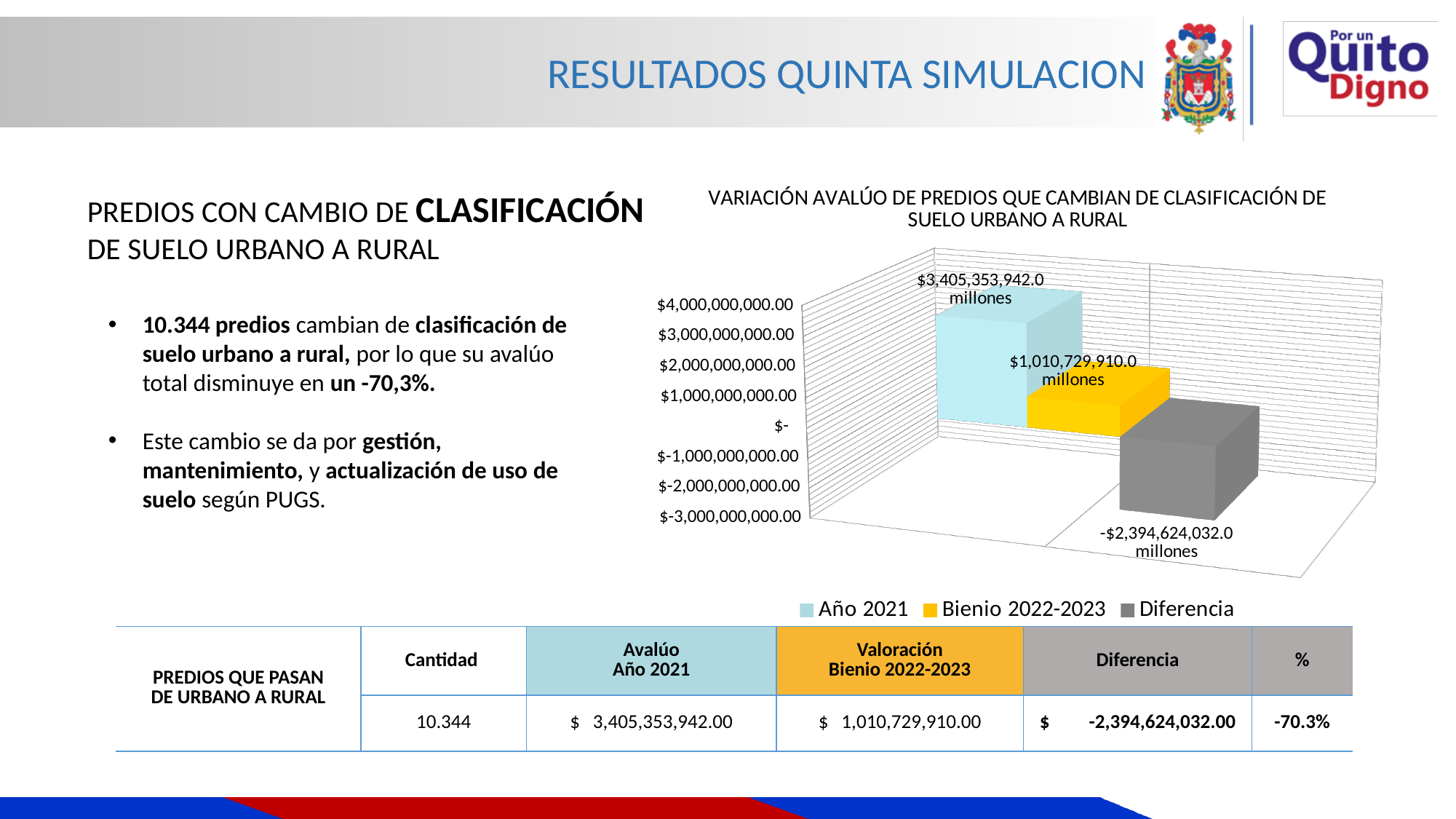
Which legend entry is shown in yellow in the chart? Bienio 2022-2023 What is the title of the chart? VARIACIÓN AVALÚO DE PREDIOS QUE CAMBIAN DE CLASIFICACIÓN DE SUELO URBANO A RURAL Which series has the lowest value in the chart? Diferencia What is the value shown for Año 2021 in the chart? $3,405,353,942.0 millones Which is larger, the value for Año 2021 or the value for Bienio 2022-2023? Año 2021 Which series has the highest value in the chart? Año 2021 What is the value shown for Bienio 2022-2023 in the chart? $1,010,729,910.0 millones What type of chart is shown on the slide? bar chart Is the value for Año 2021 greater or less than $3,000,000,000.00? greater Is the value for Bienio 2022-2023 greater or less than $2,000,000,000.00? less How many series does the chart legend list? 3 What is the value shown for Diferencia in the chart? -$2,394,624,032.0 millones